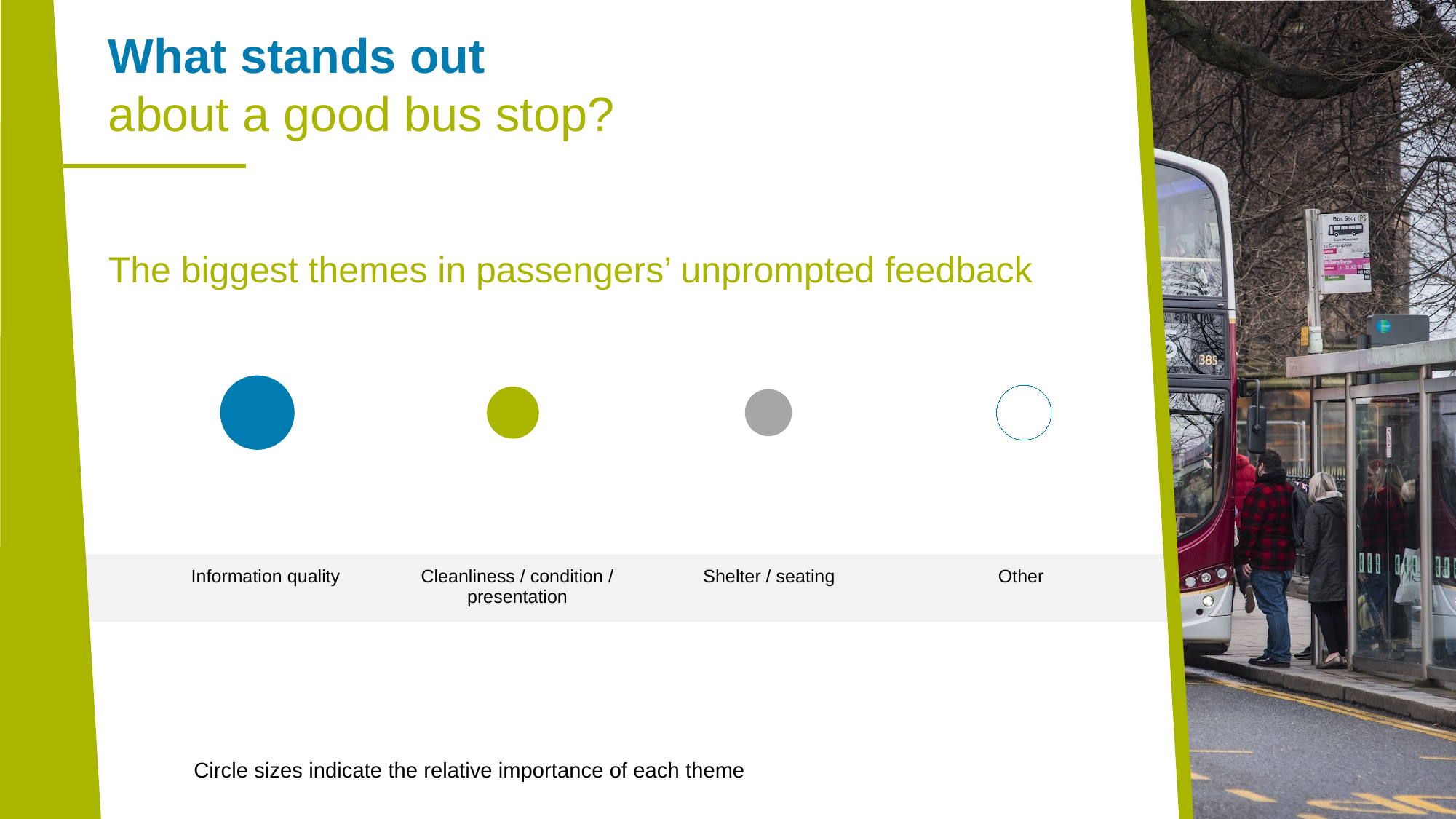
How many themes are shown as circles in the chart? 4 Which circle is larger: Information quality or Cleanliness / condition / presentation? Information quality Which circle is larger: Information quality or Other? Information quality What kind of chart is used to show the themes in passengers' feedback? Bubble chart According to the note on the slide, what do the circle sizes indicate? The relative importance of each theme Which circle is larger: Information quality or Shelter / seating? Information quality Which theme has the largest circle in the chart? Information quality What colour is the circle for Information quality? Blue Which theme has the smallest circle in the chart? Shelter / seating